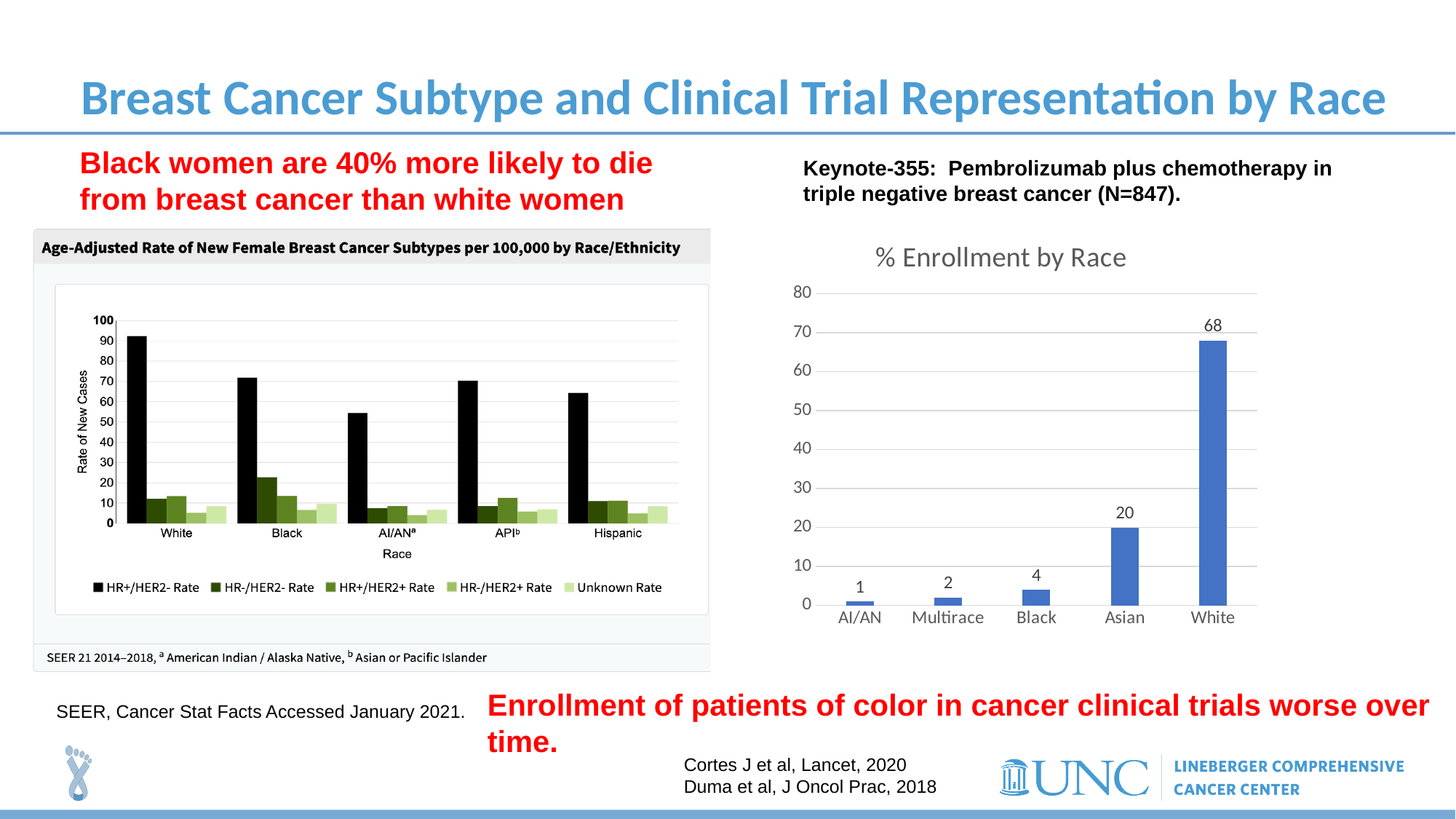
In the '% Enrollment by Race' chart, which category has the lowest value? AI/AN In the 'Age-Adjusted Rate of New Female Breast Cancer Subtypes' chart, which race has the highest HR+/HER2- Rate? White What kind of chart is the '% Enrollment by Race' chart? Bar chart In the '% Enrollment by Race' chart, how many categories are shown on the x axis? 5 In the '% Enrollment by Race' chart, what is the value for White? 68 In the '% Enrollment by Race' chart, what is the value for Asian? 20 In the 'Age-Adjusted Rate of New Female Breast Cancer Subtypes' chart, how many series does the legend list? 5 In the 'Age-Adjusted Rate of New Female Breast Cancer Subtypes' chart, is the HR+/HER2- Rate for AI/AN greater or less than 60? less In the '% Enrollment by Race' chart, what is the difference between the values for White and Asian? 48 In the '% Enrollment by Race' chart, what is the value for Black? 4 In the 'Age-Adjusted Rate of New Female Breast Cancer Subtypes' chart, which race has a larger HR-/HER2- Rate, Black or White? Black In the '% Enrollment by Race' chart, which category has the highest value? White